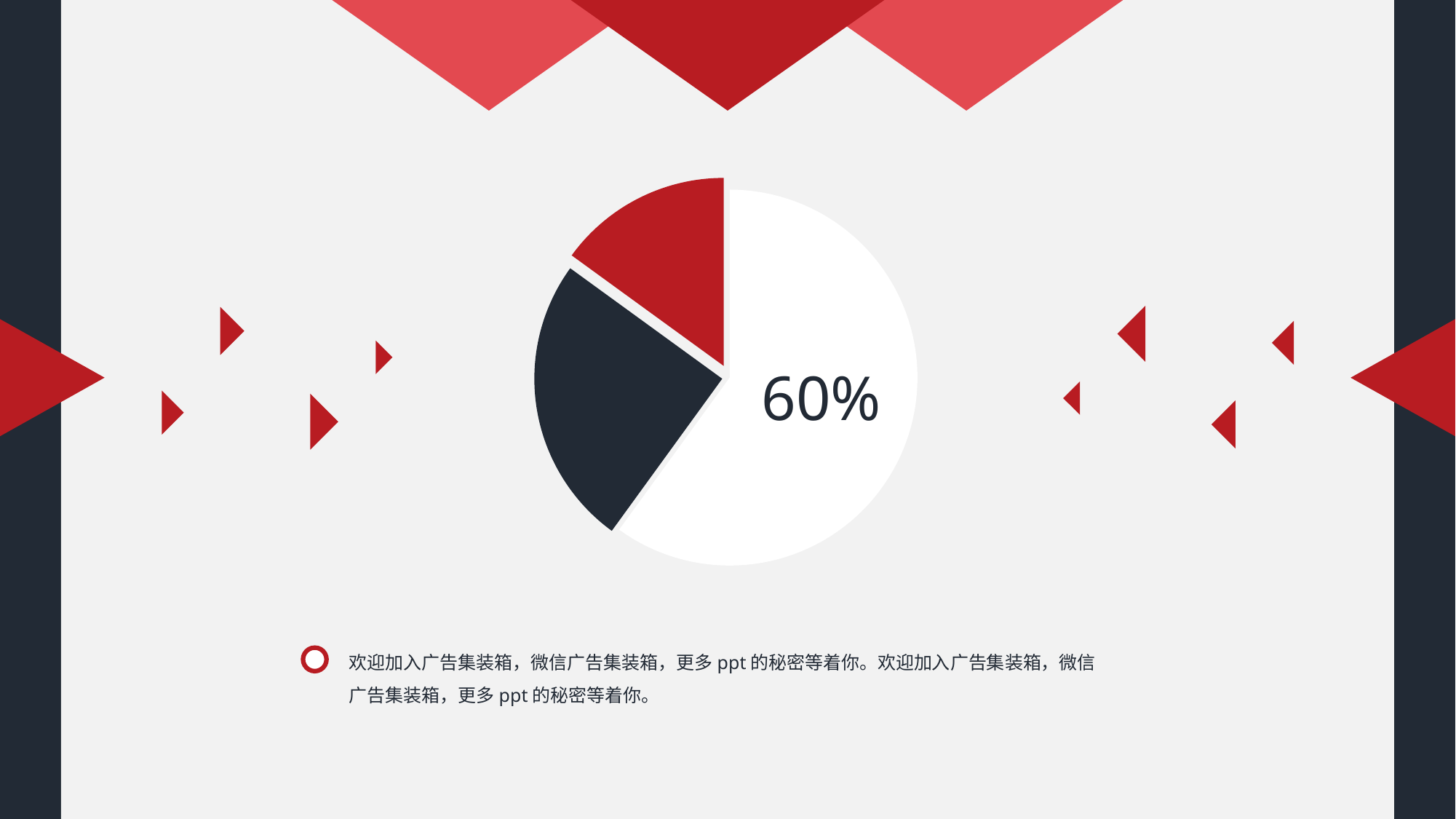
What percentage is printed inside the white slice of the pie chart? 60% Is the share of the white slice greater or less than 50%? greater Which slice of the pie chart is the largest? the white slice What colours are the three slices of the pie chart? white, dark navy and red What kind of chart is shown on the slide? pie chart How many slices does the pie chart have? 3 Which slice is larger, the dark navy slice or the red slice? the dark navy slice Does the pie chart have a legend? No Which slice of the pie chart is the smallest? the red slice